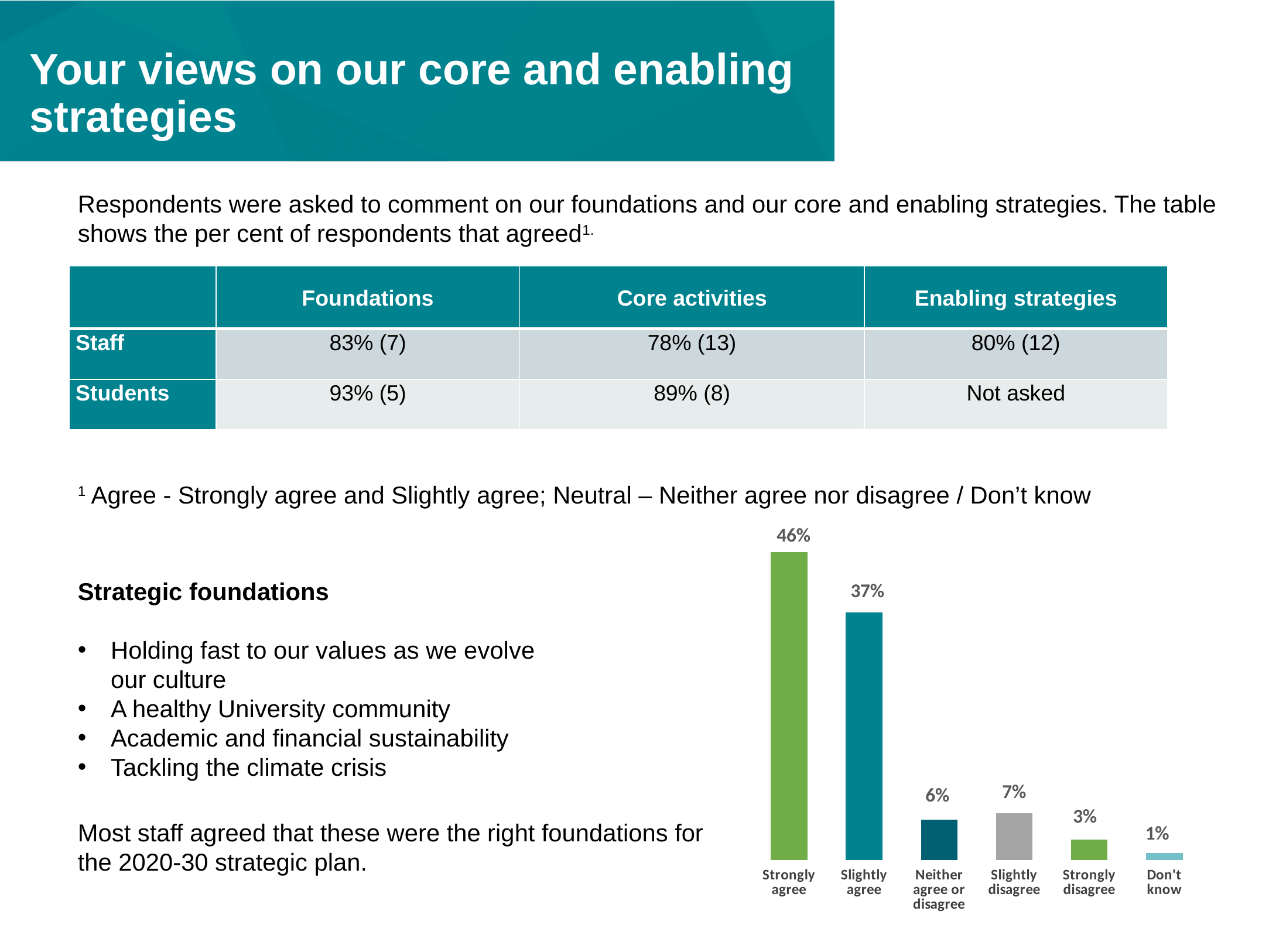
What colour is the 'Slightly disagree' bar in the chart? Grey In the bar chart, which is larger: 'Slightly disagree' or 'Strongly disagree'? Slightly disagree What type of chart is shown on the slide? Bar chart What percentage of respondents chose 'Slightly agree' in the bar chart? 37% What is the combined value of 'Strongly agree' and 'Slightly agree' in the bar chart? 83% What percentage of respondents chose 'Strongly agree' in the bar chart? 46% What is the difference between the 'Strongly agree' and 'Slightly agree' values in the bar chart? 9% Which response category has the highest value in the bar chart? Strongly agree What percentage of respondents chose 'Neither agree or disagree' in the bar chart? 6% What percentage of respondents chose 'Don't know' in the bar chart? 1% Which response category has the lowest value in the bar chart? Don't know How many response categories are shown in the bar chart? 6